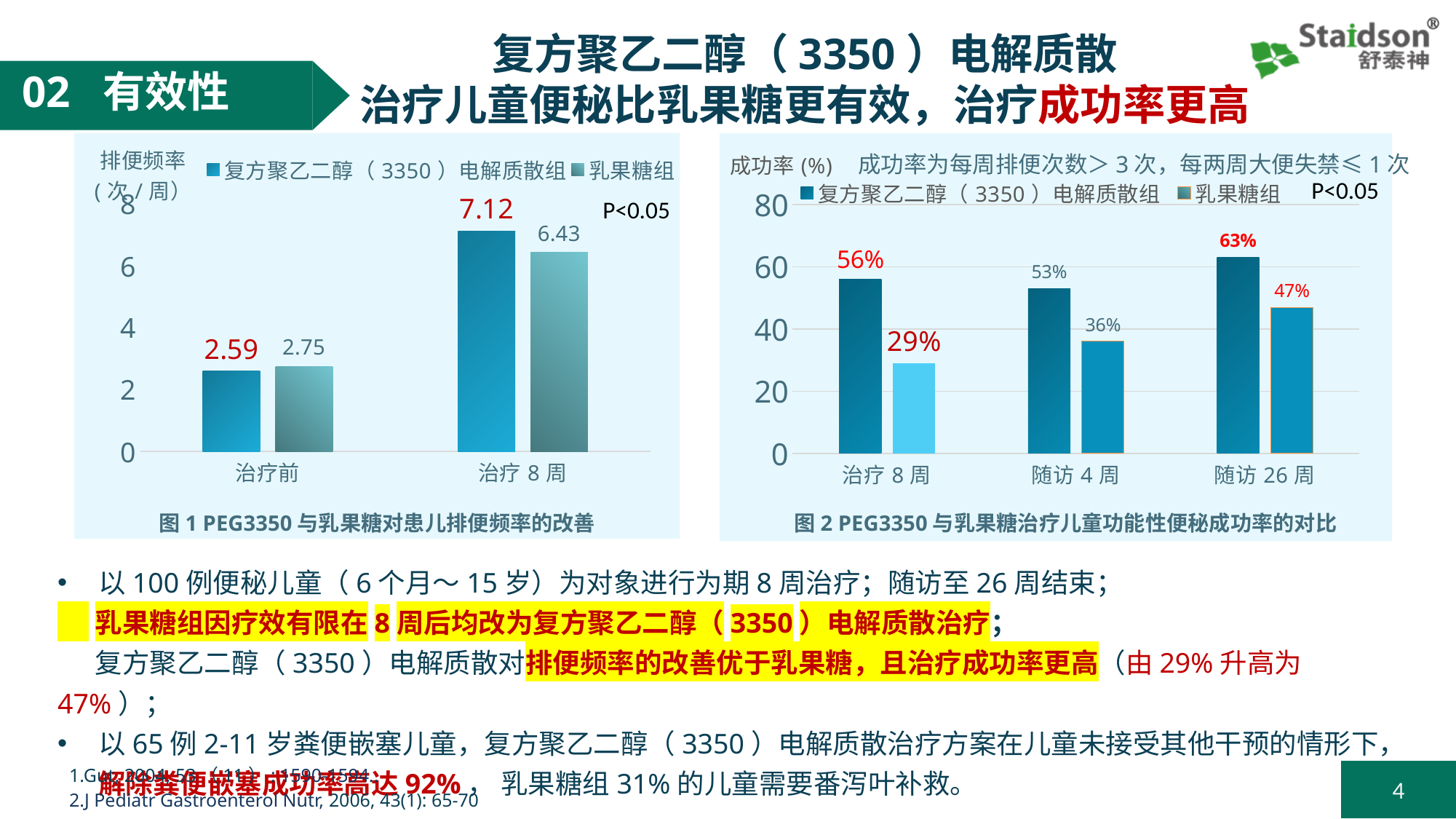
In the left chart (图1), what is the value for the 复方聚乙二醇（3350）电解质散组 at 治疗 8 周? 7.12 In the left chart (图1), what is the value for the 乳果糖组 at 治疗前? 2.75 What type of chart is the right chart (图2)? bar chart In the right chart (图2), how many series does the legend list? 2 In the left chart (图1), which group has the higher value at 治疗 8 周? 复方聚乙二醇（3350）电解质散组 In the right chart (图2), what is the success rate for the 复方聚乙二醇（3350）电解质散组 at 随访 26 周? 63% In the right chart (图2), what is the difference between the two groups at 随访 4 周? 17% In the left chart (图1), does the value for the 复方聚乙二醇（3350）电解质散组 rise or fall from 治疗前 to 治疗 8 周? rise In the right chart (图2), which category has the lowest value for the 乳果糖组? 治疗 8 周 In the left chart (图1), how many categories are shown on the x axis? 2 In the left chart (图1), what is the difference between the two groups at 治疗 8 周? 0.69 In the right chart (图2), what is the success rate for the 乳果糖组 at 治疗 8 周? 29%